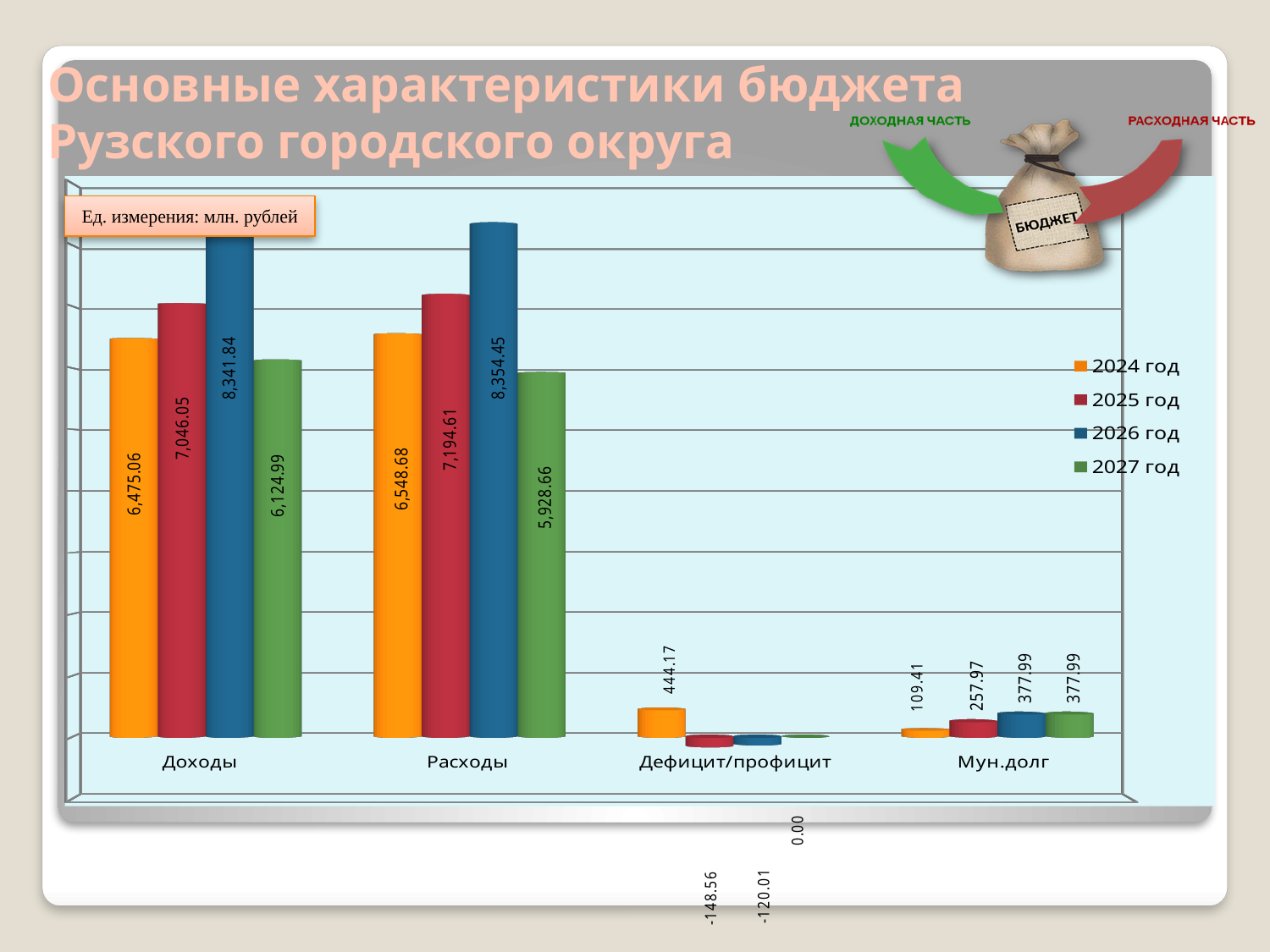
What is the value for Дефицит/профицит in 2025 год? -148.56 Which year has the highest value for Доходы? 2026 год What is the difference between Мун.долг in 2026 год and in 2025 год? 120.02 What is the difference between Расходы and Доходы in 2024 год? 73.62 How many series does the legend list? 4 What kind of chart is shown on the slide? Bar chart How many categories are shown on the x axis? 4 What is the value for Расходы in 2027 год? 5,928.66 Which is larger in 2025 год: Доходы or Расходы? Расходы Which year has the lowest value for Расходы? 2027 год What is the value for Доходы in 2026 год? 8,341.84 What is the value for Мун.долг in 2024 год? 109.41